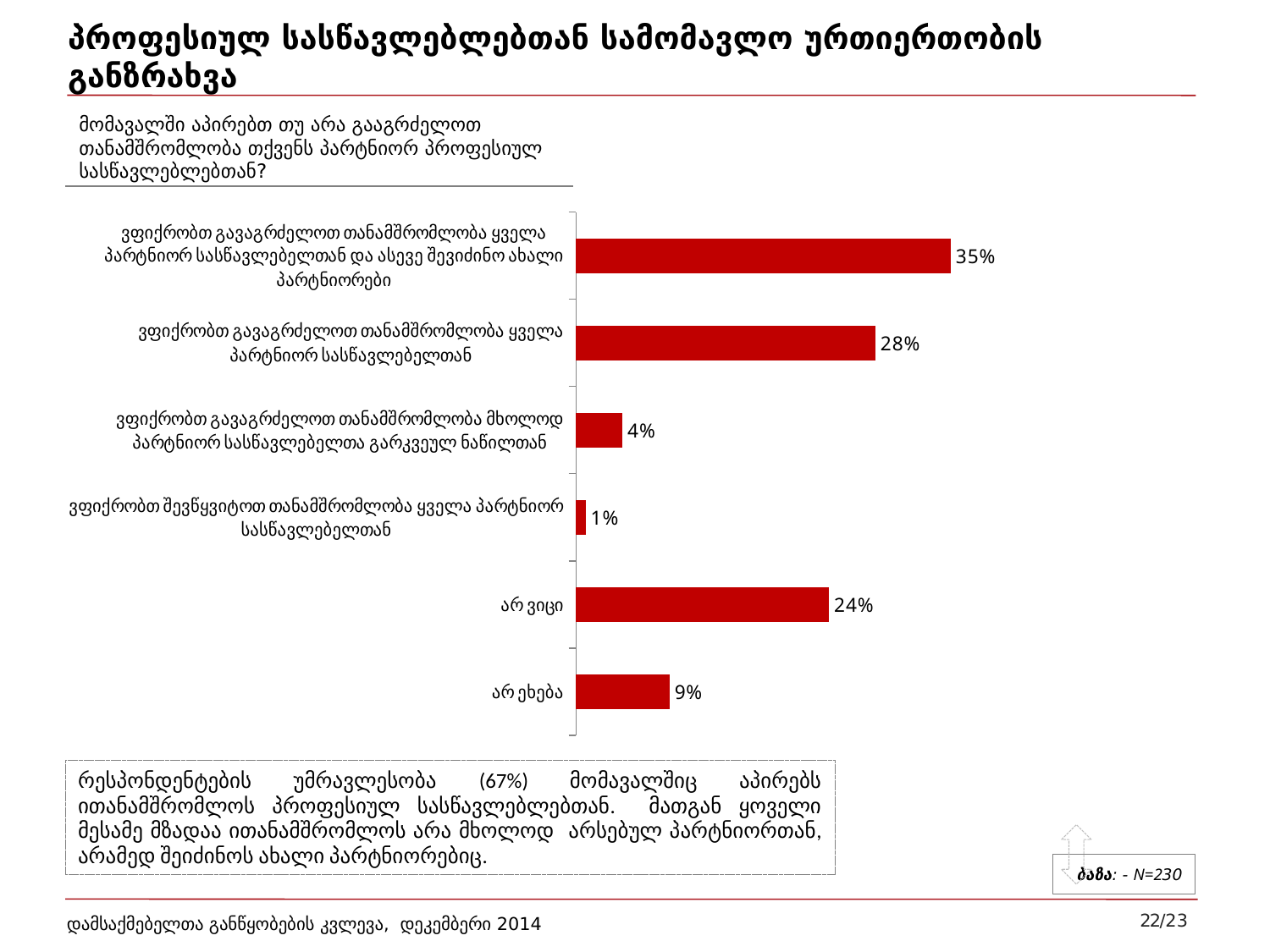
What is the difference between the value for "ვფიქრობთ გავაგრძელოთ თანამშრომლობა ყველა პარტნიორ სასწავლებელთან" and the value for "ვფიქრობთ გავაგრძელოთ თანამშრომლობა მხოლოდ პარტნიორ სასწავლებელთა გარკვეულ ნაწილთან"? 24% What is the difference between the highest value (35%) and the value for "არ ვიცი"? 11% What sample size (N) is noted on the slide? N=230 What is the value for "ვფიქრობთ შევწყვიტოთ თანამშრომლობა ყველა პარტნიორ სასწავლებელთან"? 1% Which category has the lowest value? ვფიქრობთ შევწყვიტოთ თანამშრომლობა ყველა პარტნიორ სასწავლებელთან What kind of chart is shown on the slide? bar chart How many categories are plotted in the chart? 6 What is the value for "ვფიქრობთ გავაგრძელოთ თანამშრომლობა ყველა პარტნიორ სასწავლებელთან"? 28% What is the value for "არ ვიცი"? 24% Which category has the highest value? ვფიქრობთ გავაგრძელოთ თანამშრომლობა ყველა პარტნიორ სასწავლებელთან და ასევე შევიძინო ახალი პარტნიორები Which is larger: the value for "არ ვიცი" or the value for "არ ეხება"? არ ვიცი What is the value for "არ ეხება"? 9%